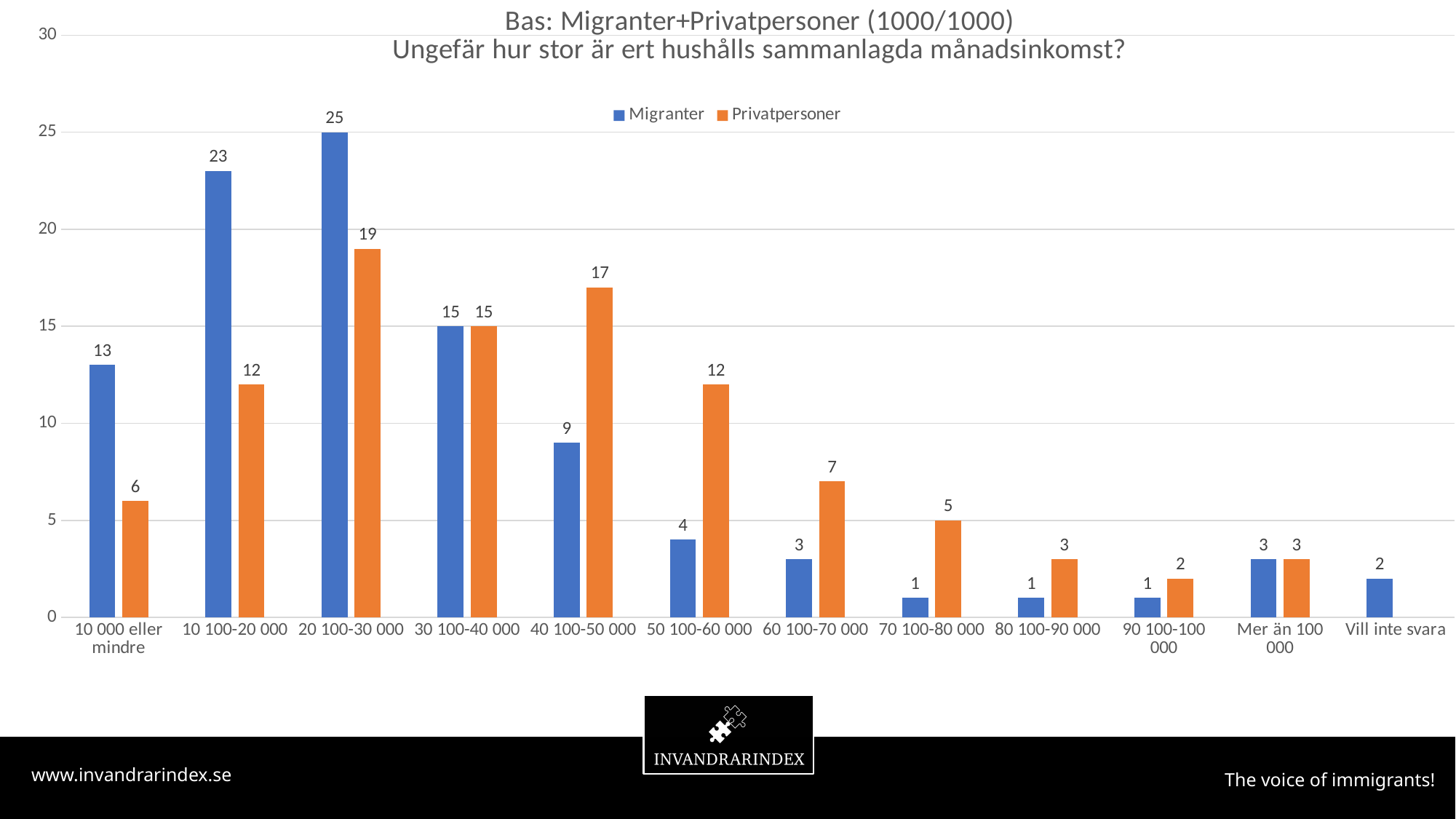
Which category has the highest Privatpersoner value? 20 100-30 000 Is the Migranter value for 10 000 eller mindre greater or less than 10? greater What is the difference between the Migranter and Privatpersoner values for the 10 100-20 000 category? 11 What is the Migranter value for the 20 100-30 000 category? 25 How many series does the legend list? 2 For the 50 100-60 000 category, which series has the larger value, Migranter or Privatpersoner? Privatpersoner Which category has the lowest Migranter value? 70 100-80 000, 80 100-90 000 and 90 100-100 000 (all 1) What kind of chart is shown on the slide? Bar chart What is the Migranter value for the Vill inte svara category? 2 How many income categories are shown on the x axis? 12 Which colour represents the Privatpersoner series? Orange What is the Privatpersoner value for the 40 100-50 000 category? 17